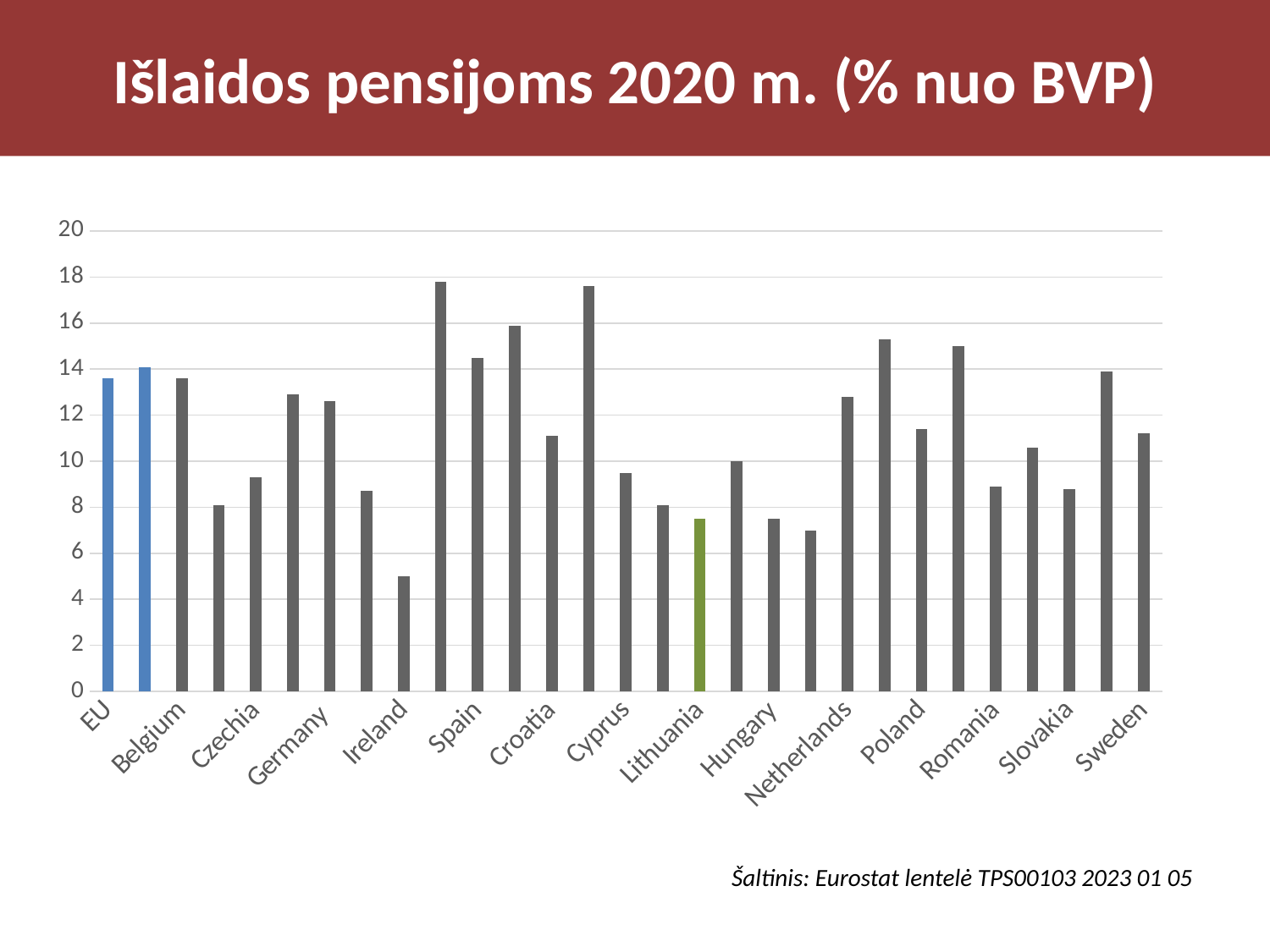
Which has the larger value, Spain or Germany? Spain Is the value for Germany greater or less than 12? greater What kind of chart is shown on the slide? bar chart What is the title of the chart? Išlaidos pensijoms 2020 m. (% nuo BVP) Is the value for Czechia greater or less than 10? less Is the value for Sweden greater or less than 10? greater Which labelled country has the lowest bar in the chart? Ireland What colour is the bar for Lithuania? green Which has the larger value, Netherlands or Poland? Netherlands